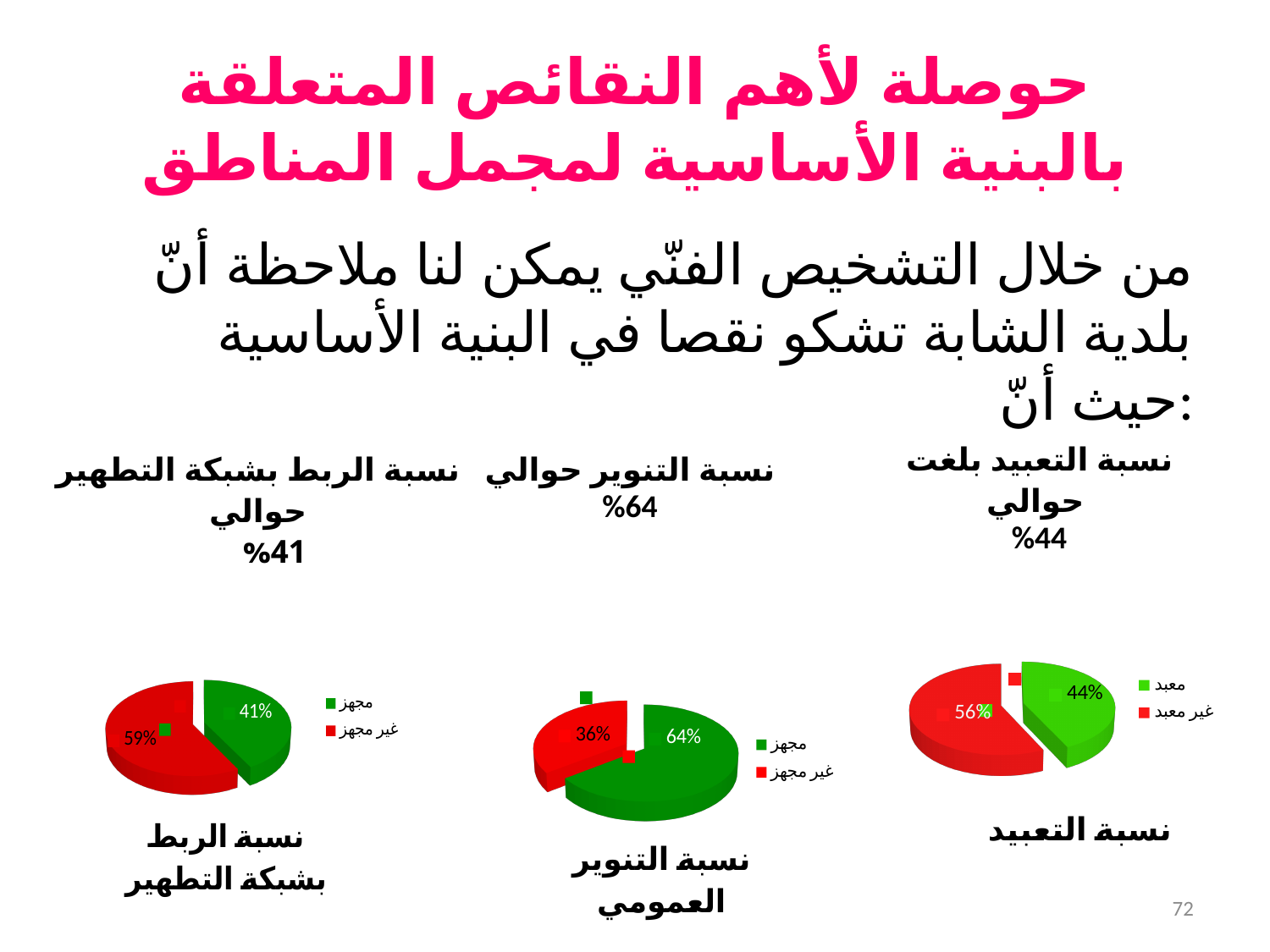
In the chart titled نسبة التنوير العمومي, which is larger, مجهز or غير مجهز? مجهز In the chart titled نسبة الربط بشبكة التطهير, which category is the largest? غير مجهز In the chart titled نسبة التنوير العمومي, what is the value for مجهز? 64% In the chart titled نسبة الربط بشبكة التطهير, what is the value for مجهز? 41% How many series does the legend of the chart titled نسبة الربط بشبكة التطهير list? 2 In the chart titled نسبة التعبيد, what is the value for غير معبد? 56% In the chart titled نسبة التنوير العمومي, what is the value for غير مجهز? 36% In the chart titled نسبة التعبيد, what is the difference between غير معبد and معبد? 12% In the chart titled نسبة التنوير العمومي, which category is the smallest? غير مجهز How many pie charts are shown on the slide? 3 What kind of chart is the chart titled نسبة التعبيد? Pie chart In the chart titled نسبة التعبيد, what is the value for معبد? 44%